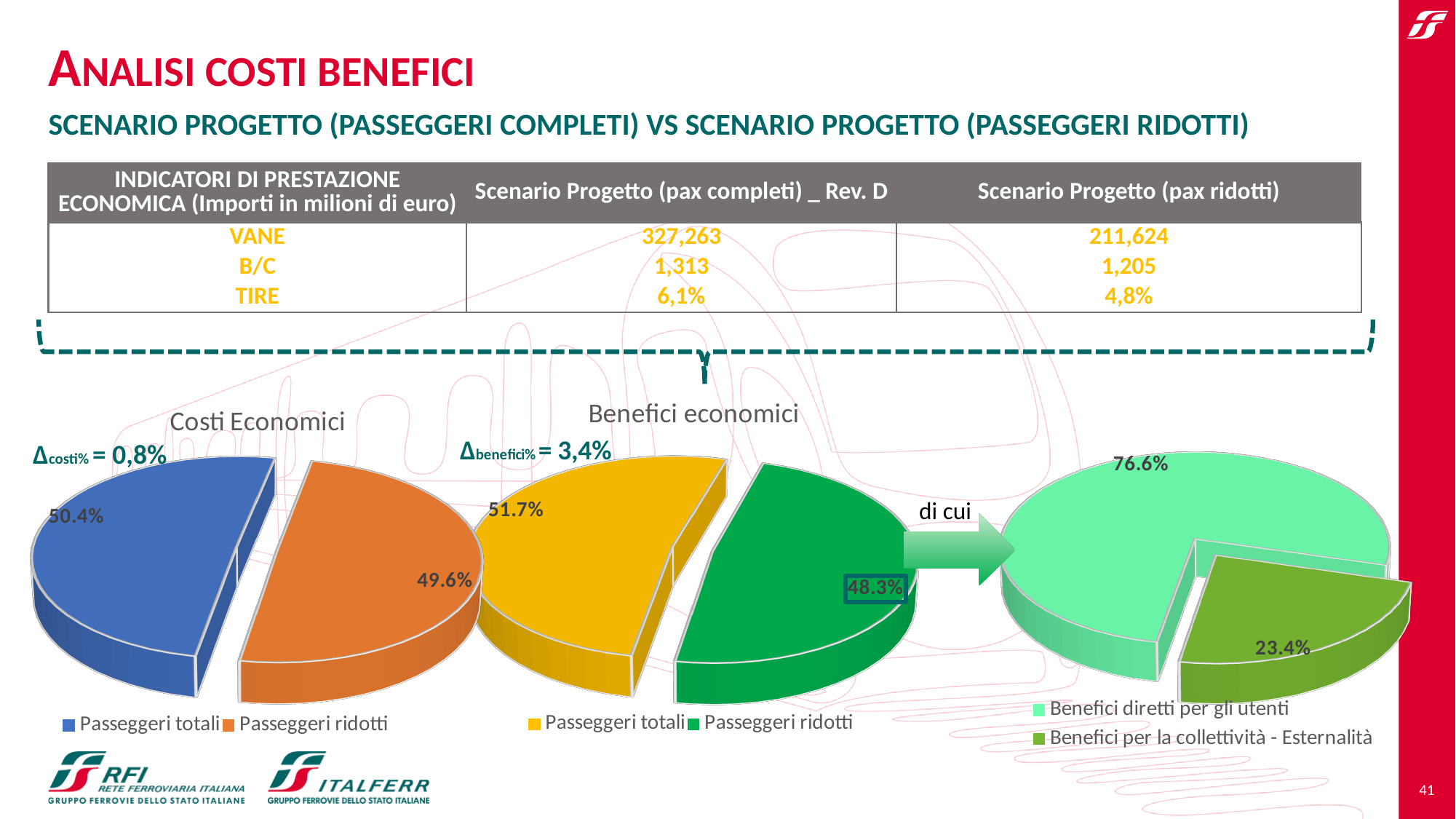
What kind of chart is the 'Costi Economici' chart? Pie chart In the rightmost pie chart, what share is labelled for Benefici per la collettività - Esternalità? 23.4% How many entries does the legend of the rightmost pie chart list? 2 In the 'Benefici economici' pie chart, what is the difference between the Passeggeri totali and Passeggeri ridotti shares? 3.4% In the 'Costi Economici' pie chart, what share is labelled for Passeggeri ridotti? 49.6% In the 'Benefici economici' pie chart, what share is labelled for Passeggeri ridotti? 48.3% In the 'Benefici economici' pie chart, which slice is the smallest? Passeggeri ridotti In the rightmost pie chart, which slice is the largest? Benefici diretti per gli utenti In the rightmost pie chart, what is the difference between the two slices' shares? 53.2%